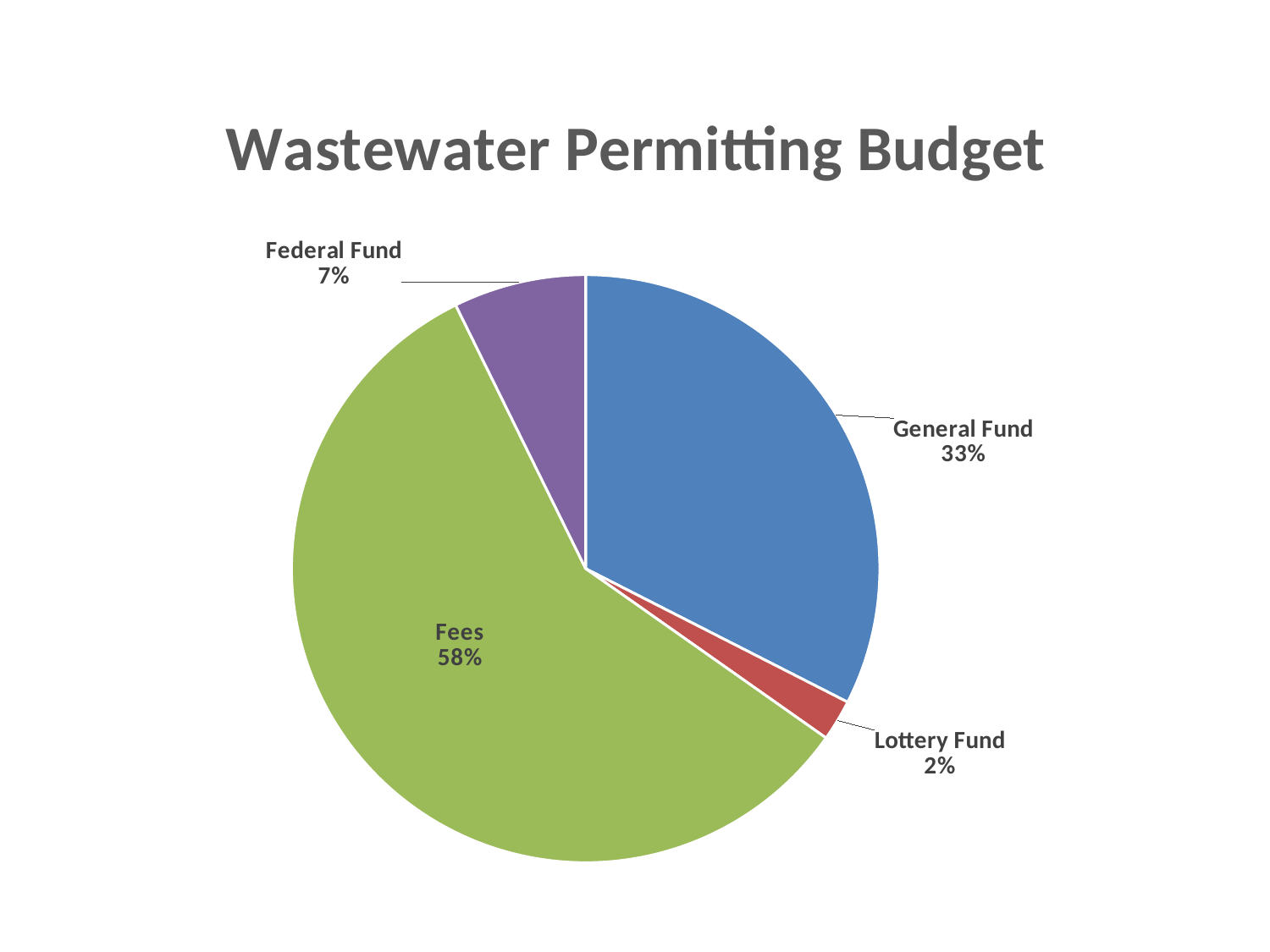
What colour is the Fees slice? green Which funding source has the smallest share of the budget? Lottery Fund Which is larger, the Federal Fund share or the Lottery Fund share? Federal Fund What share of the budget comes from Fees? 58% What share of the budget comes from the General Fund? 33% Which funding source has the largest share of the budget? Fees How many slices does the pie chart have? 4 What is the title of the chart? Wastewater Permitting Budget What is the difference in percentage points between Fees and the General Fund? 25 What kind of chart is shown on the slide? pie chart What share of the budget comes from the Federal Fund? 7% What share of the budget comes from the Lottery Fund? 2%